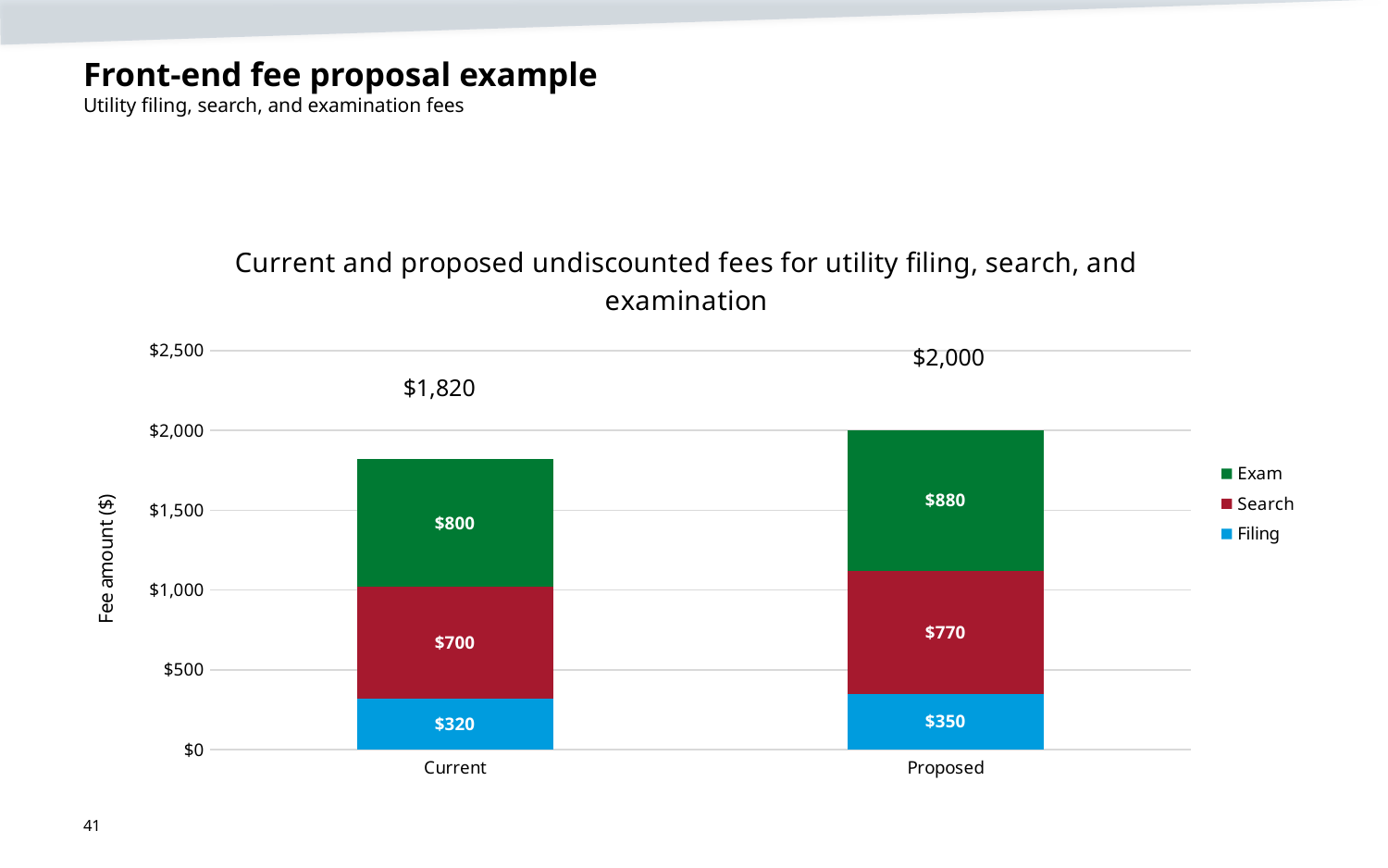
What is the total of the stacked bar for Proposed? $2,000 What kind of chart is shown on the slide? Stacked bar chart How many series does the legend list? 3 What is the total of the stacked bar for Current? $1,820 What is the difference between the Proposed and Current Exam fees? $80 What is the Search fee for the Proposed category? $770 What is the Filing fee for the Current category? $320 What is the label on the vertical axis? Fee amount ($) What is the Exam fee for the Proposed category? $880 Which fee component is the largest in the Current bar? Exam What is the difference between the Proposed and Current Search fees? $70 Which category has the higher total fee, Current or Proposed? Proposed